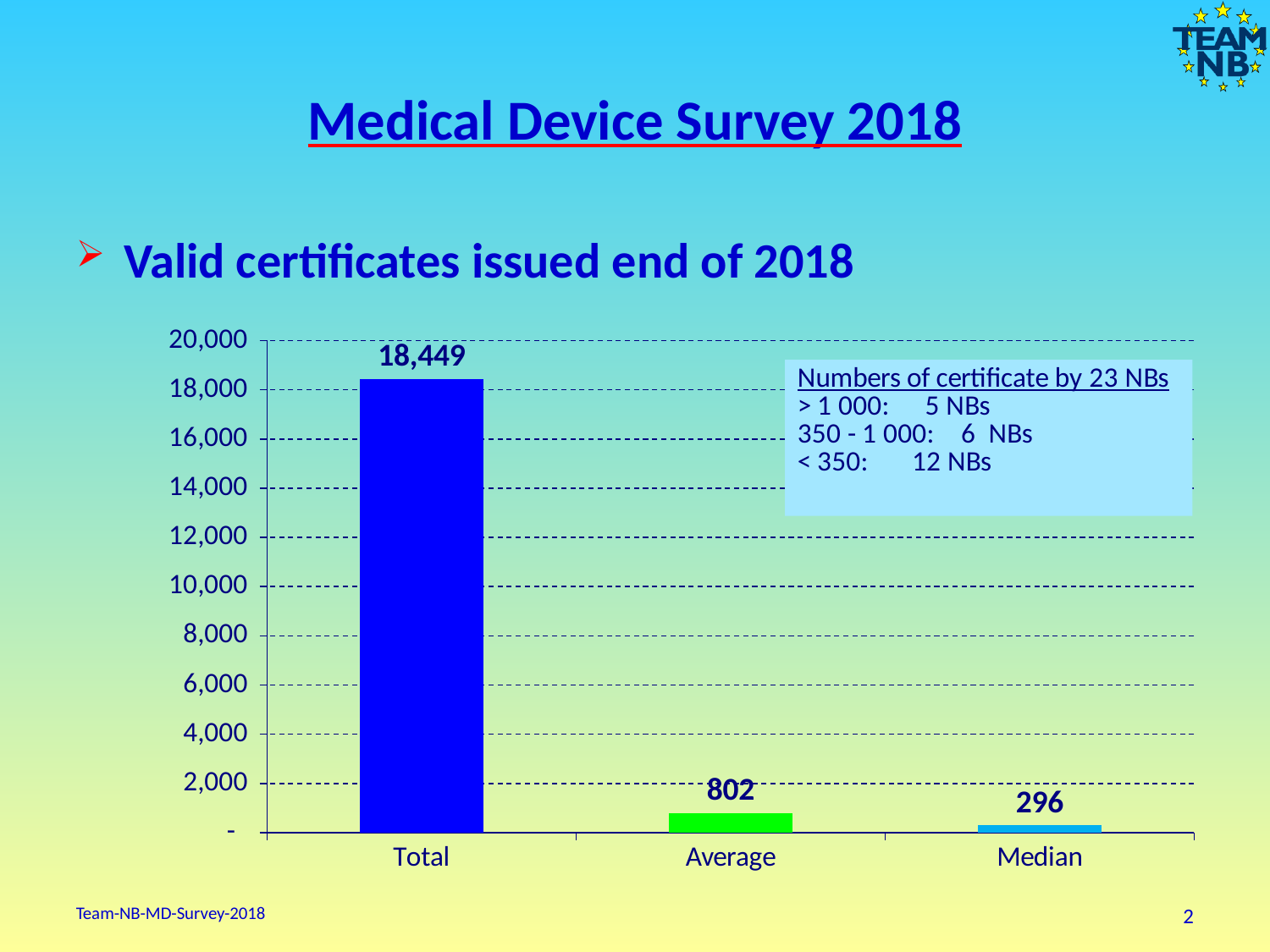
How many categories are shown on the x axis? 3 What is the difference between the Average and Median values? 506 What is the difference between the Total and Average values? 17,647 What is the value of the Median bar? 296 Which is larger, the Average or the Median value? Average According to the text box on the chart, how many NBs have more than 1 000 certificates? 5 NBs What kind of chart is shown on the slide? bar chart Which category has the highest value? Total What is the value of the Average bar? 802 Is the value for Average greater or less than 2,000? less What is the value of the Total bar? 18,449 Which category has the lowest value? Median